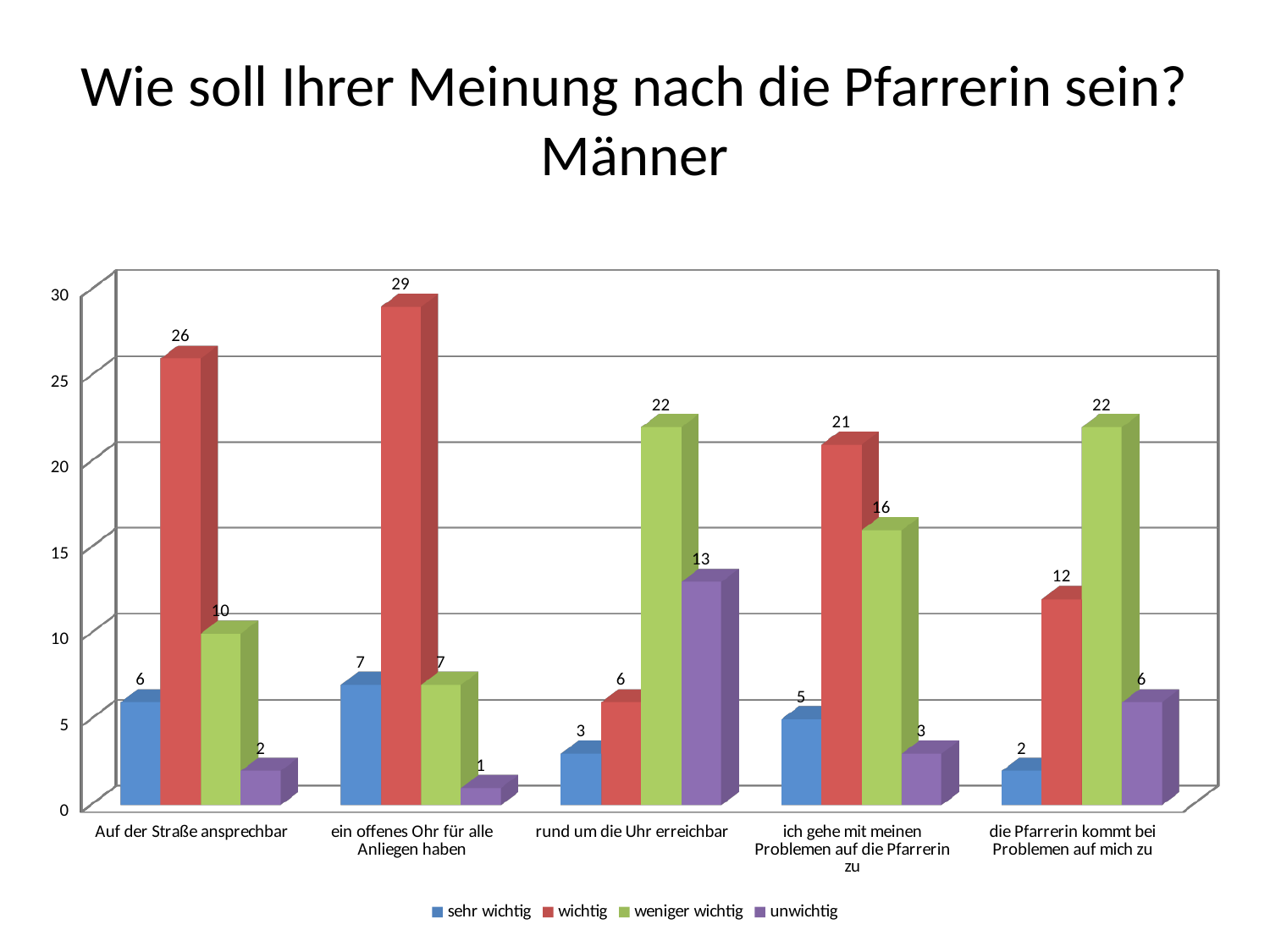
How many series does the legend list? 4 What is the value for "unwichtig" in the category "rund um die Uhr erreichbar"? 13 How many categories are shown on the x axis? 5 Is the value for "wichtig" in "Auf der Straße ansprechbar" greater or less than 25? greater Which series is shown in green in the legend? weniger wichtig Which category has the highest value for "wichtig"? ein offenes Ohr für alle Anliegen haben What kind of chart is shown on the slide? bar chart What is the value for "wichtig" in the category "ein offenes Ohr für alle Anliegen haben"? 29 What is the value for "weniger wichtig" in the category "ich gehe mit meinen Problemen auf die Pfarrerin zu"? 16 Which category has the lowest value for "sehr wichtig"? die Pfarrerin kommt bei Problemen auf mich zu What is the difference between the "wichtig" values for "Auf der Straße ansprechbar" and "die Pfarrerin kommt bei Problemen auf mich zu"? 14 Which is larger in the category "rund um die Uhr erreichbar": "weniger wichtig" or "unwichtig"? weniger wichtig